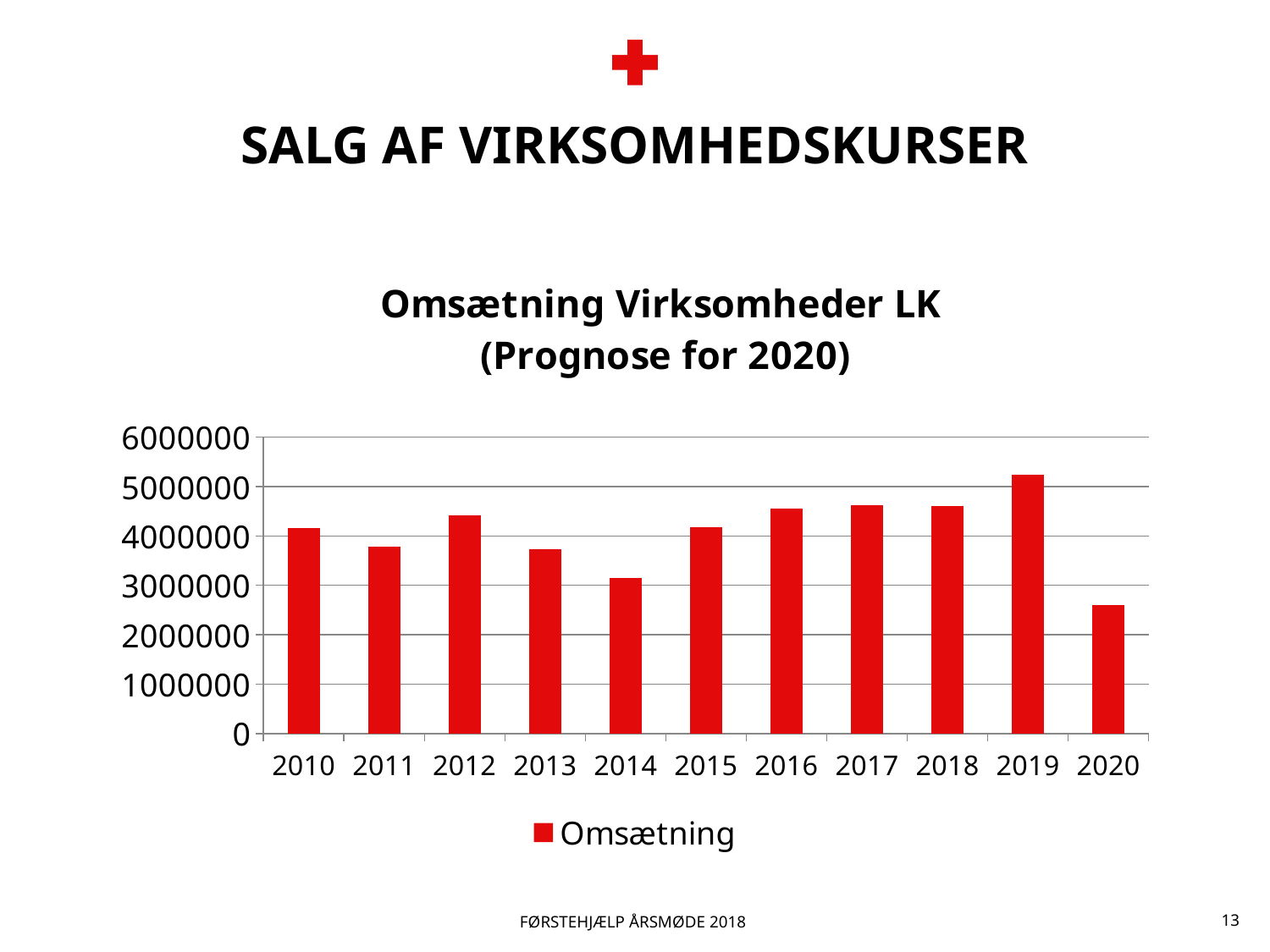
What kind of chart is shown on the slide? Bar chart Which year has the lowest Omsætning value? 2020 Which year has the larger value, 2014 or 2012? 2012 What is the title of the chart? Omsætning Virksomheder LK (Prognose for 2020) Is the value for 2020 greater or less than 3000000? less How many years are shown on the x axis? 11 Which year has the highest Omsætning value? 2019 Do the values rise or fall from 2014 to 2019? Rise Is the value for 2011 greater or less than 4000000? less Is the value for 2012 greater or less than 4000000? greater How many series does the legend list? 1